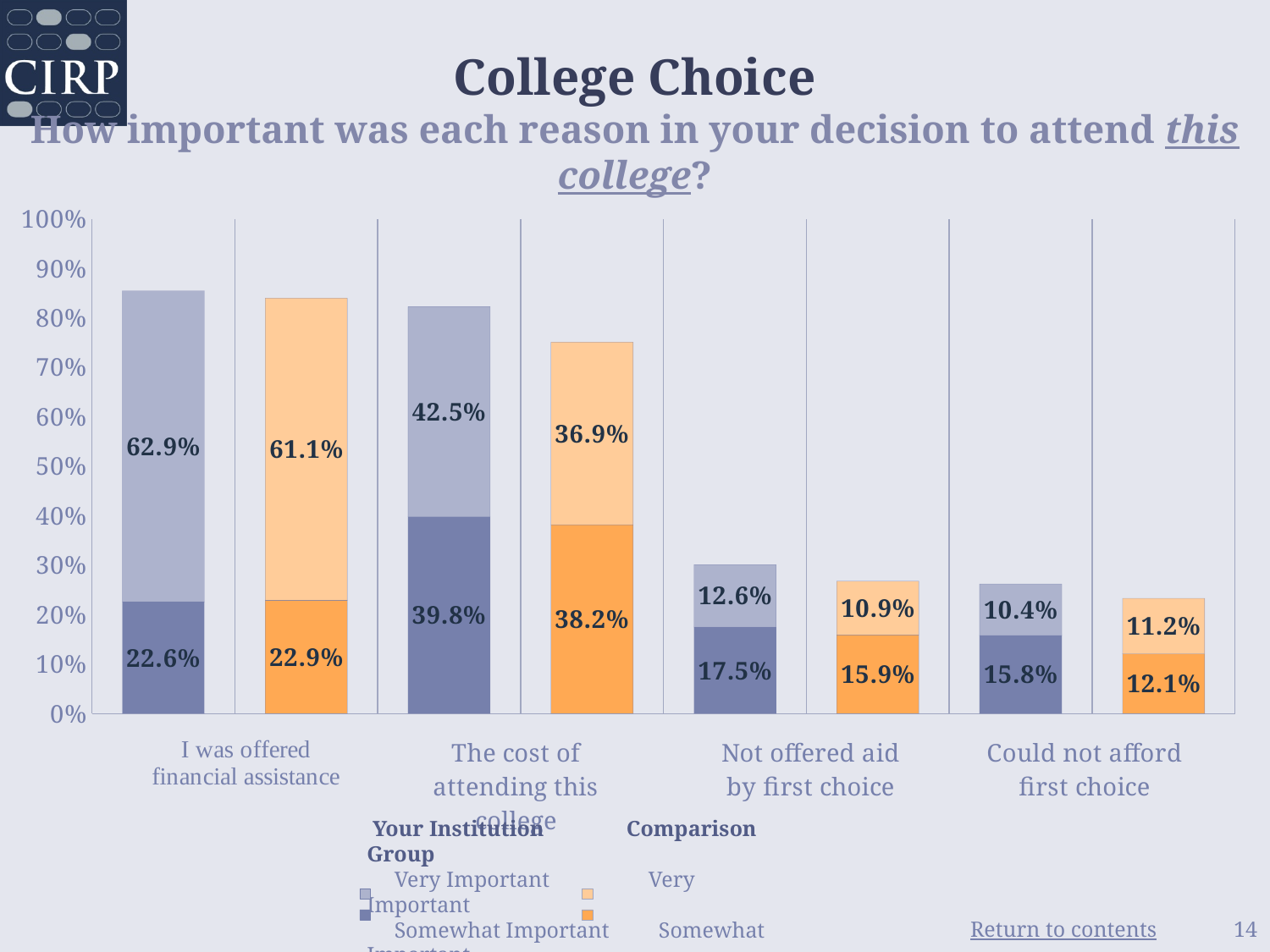
What percentage of students at Your Institution rated "Could not afford first choice" as Somewhat Important? 15.8% What is the total stacked percentage for the Comparison Group on "I was offered financial assistance"? 84.0% What percentage of students at Your Institution rated "I was offered financial assistance" as Very Important? 62.9% What type of chart is shown on the slide? Stacked bar chart What percentage of the Comparison Group rated "The cost of attending this college" as Somewhat Important? 38.2% What is the difference between the Very Important percentages for Your Institution and the Comparison Group on "The cost of attending this college"? 5.6% How many series does the legend list? 4 How many reasons (categories) are shown on the x axis of the chart? 4 Which reason has the highest Very Important percentage for Your Institution? I was offered financial assistance For "Not offered aid by first choice", which is larger: the Somewhat Important percentage for Your Institution or for the Comparison Group? Your Institution Which reason has the lowest Very Important percentage for Your Institution? Could not afford first choice What is the total stacked percentage (Very Important plus Somewhat Important) for Your Institution on "Not offered aid by first choice"? 30.1%